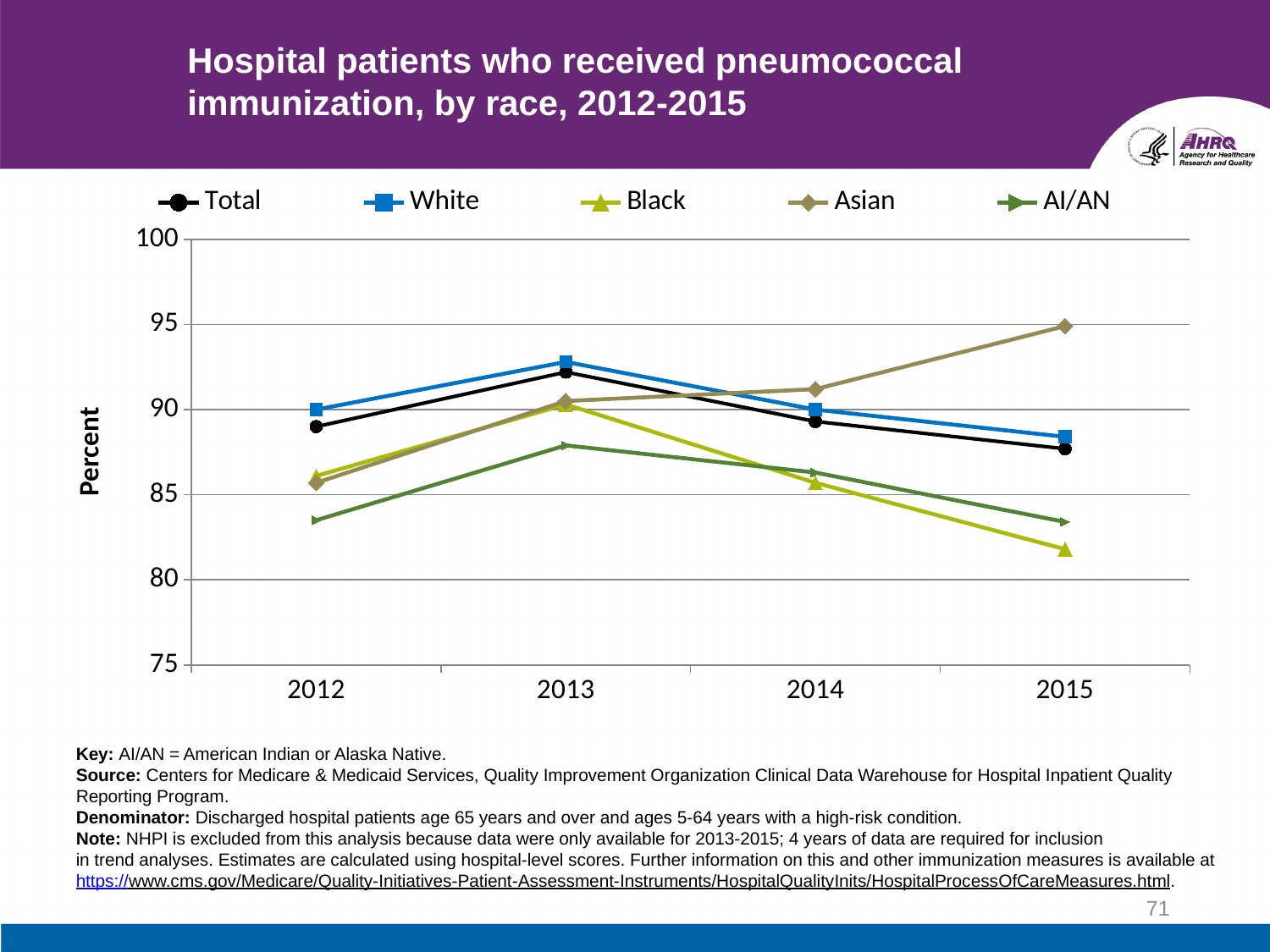
Which race group has the lowest value in 2015? Black How many series does the legend list? 5 Does the value for Asian rise or fall from 2012 to 2015? rises In 2014, which is larger, the value for White or the value for Black? White Is the value for Black in 2015 greater or less than 85? less How many years are plotted along the x axis? 4 Is the value for Asian in 2015 greater or less than 90? greater Which race group has the lowest value in 2012? AI/AN Does the value for Black rise or fall from 2013 to 2015? falls What is the label on the y axis? Percent Which race group has the highest value in 2015? Asian What kind of chart is shown on the slide? line chart